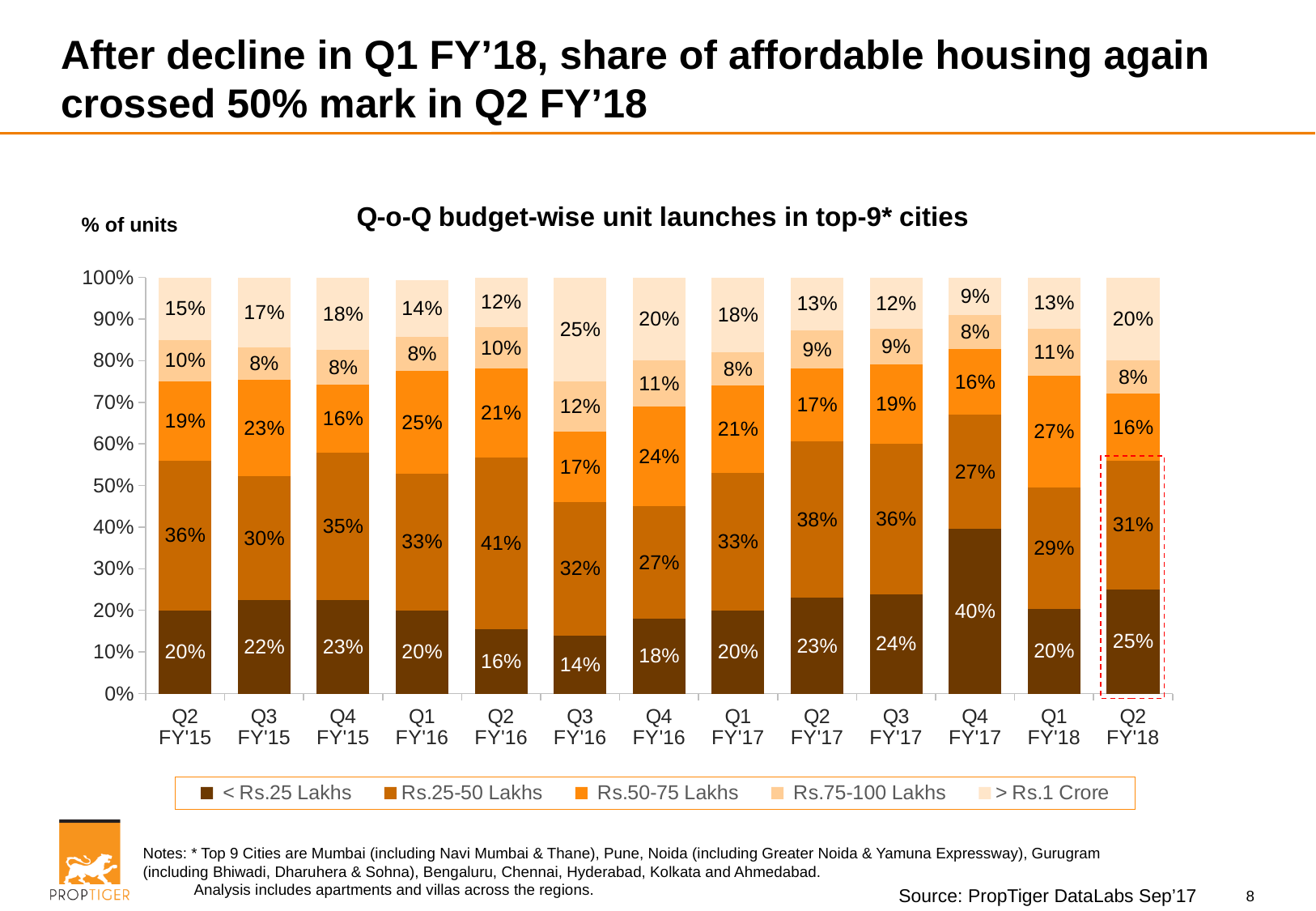
What is the value for < Rs.25 Lakhs in Q4 FY'17? 40% Which quarter has the highest share for < Rs.25 Lakhs? Q4 FY'17 How many quarters are shown on the x axis? 13 How many series does the legend list? 5 What is the value for > Rs.1 Crore in Q2 FY'18? 20% What is the difference between the Rs.50-75 Lakhs share in Q1 FY'18 and Q2 FY'18? 11 percentage points What kind of chart is shown? Stacked bar chart What is the combined share of < Rs.25 Lakhs and Rs.25-50 Lakhs in Q2 FY'18? 56% Which is larger, the Rs.25-50 Lakhs share in Q2 FY'17 or in Q3 FY'17? Q2 FY'17 Which quarter has the lowest share for < Rs.25 Lakhs? Q3 FY'16 Which quarter has the highest share for > Rs.1 Crore? Q3 FY'16 What is the value for Rs.25-50 Lakhs in Q2 FY'16? 41%